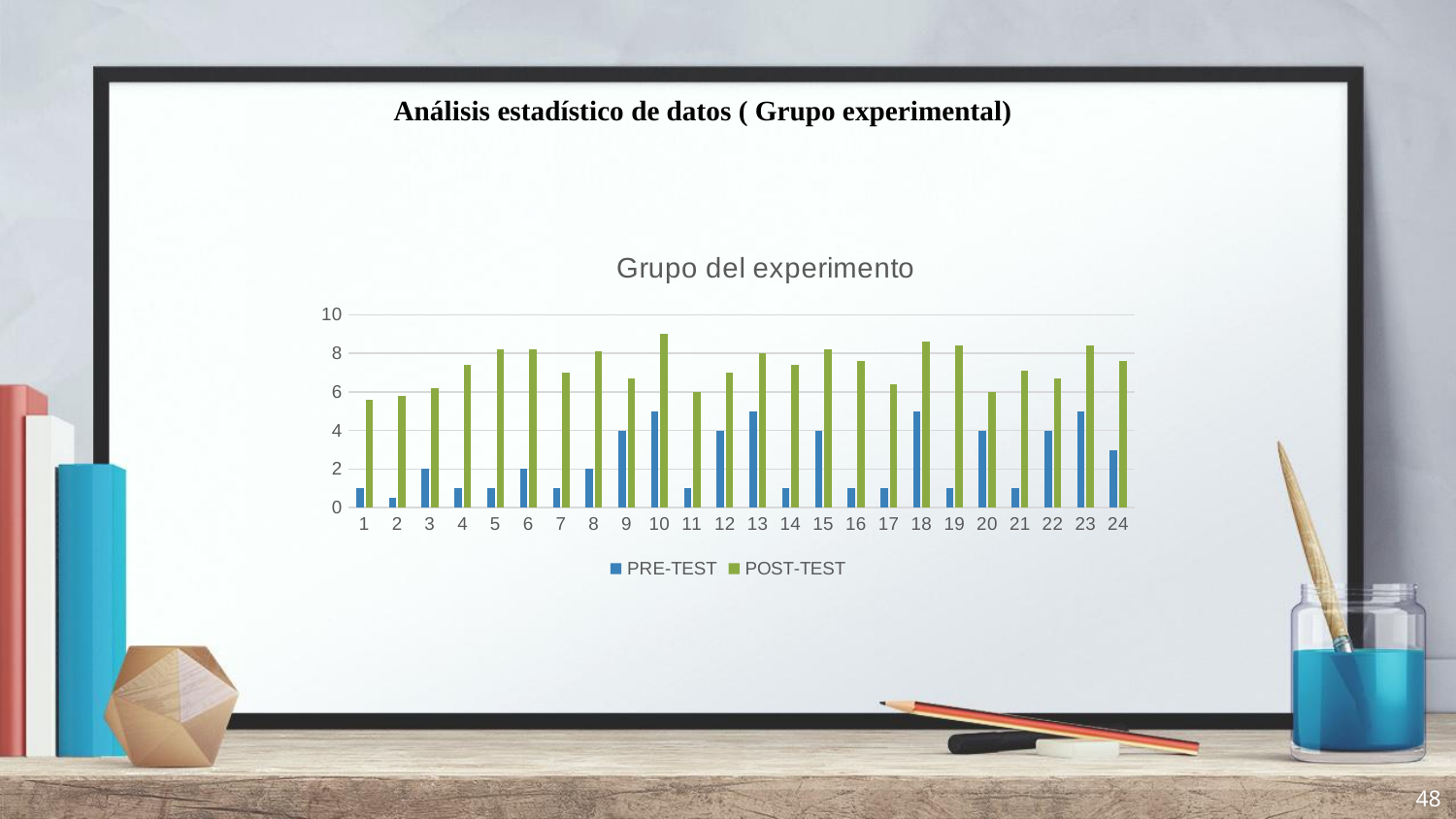
Which category has the highest POST-TEST value? 10 Which is larger, the POST-TEST value for category 10 or the POST-TEST value for category 11? category 10 What kind of chart is shown on the slide? bar chart What is the title of the chart? Grupo del experimento How many series does the legend list? 2 Is the PRE-TEST value for category 1 greater or less than 2? less What are the two series named in the legend? PRE-TEST and POST-TEST Is the POST-TEST value for category 10 greater or less than 8? greater How many categories are shown on the x axis? 24 For category 5, which is larger, the PRE-TEST value or the POST-TEST value? POST-TEST Which category has the lowest PRE-TEST value? 2 Is the POST-TEST value for category 18 greater or less than 8? greater